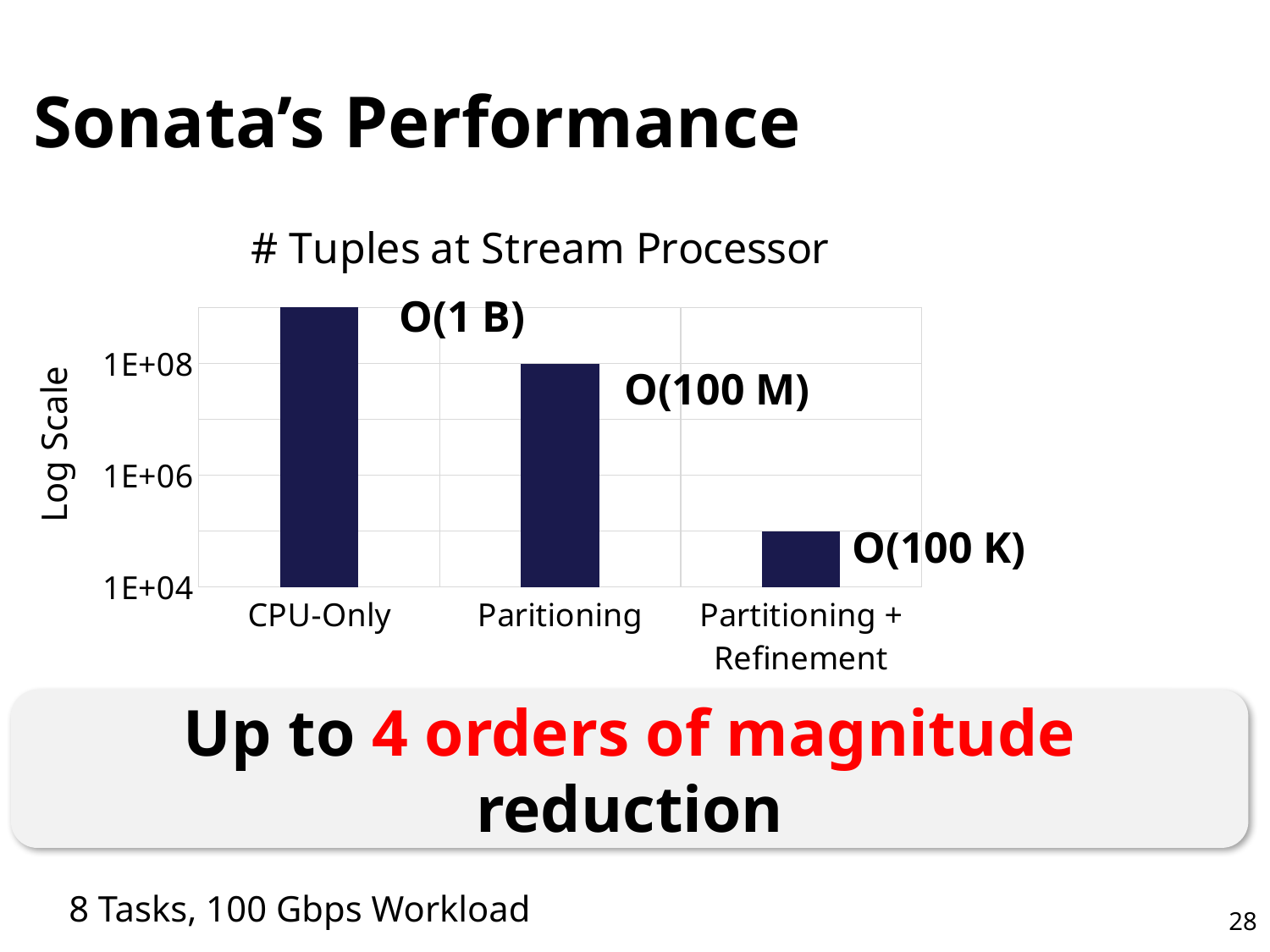
Which category has the lowest number of tuples at the stream processor? Partitioning + Refinement Is the value for Paritioning + Refinement greater or less than 1E+06? less What order-of-magnitude label is printed next to the CPU-Only bar? O(1 B) Which has fewer tuples at the stream processor, Paritioning or Paritioning + Refinement? Partitioning + Refinement Is the value for CPU-Only greater or less than 1E+08? greater How many categories are shown on the x axis of the chart? 3 What is the label on the vertical axis of the chart? Log Scale Which has more tuples at the stream processor, CPU-Only or Paritioning? CPU-Only What kind of chart is shown on the slide? bar chart Which category has the highest number of tuples at the stream processor? CPU-Only What is the title of the chart? # Tuples at Stream Processor Do the values rise or fall moving from left to right across the categories? fall